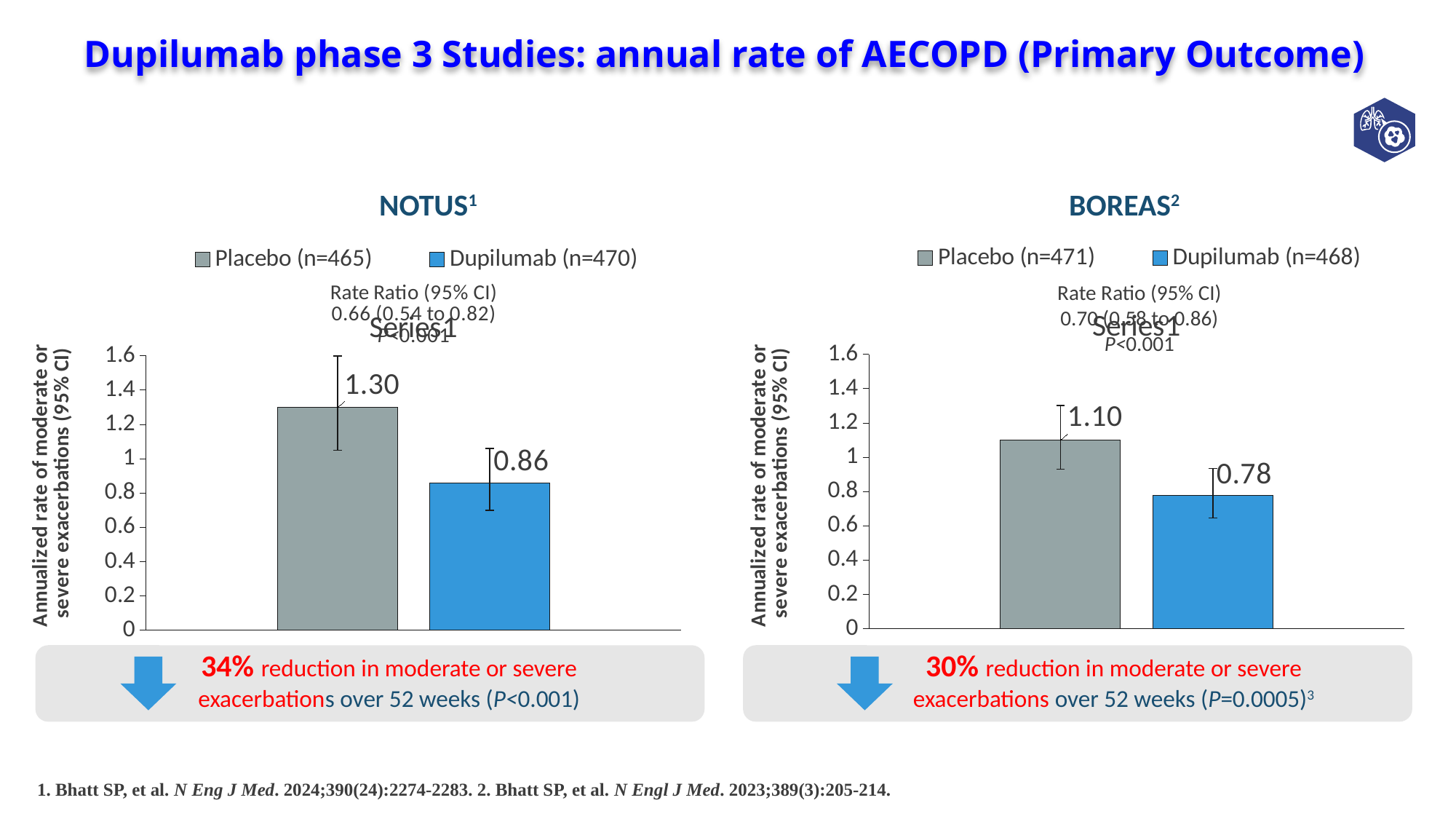
How many series does the legend of the NOTUS chart list? 2 In the BOREAS chart, what is the annualized rate of moderate or severe exacerbations for Placebo (n=471)? 1.10 In the NOTUS chart, what is the difference between the Placebo and Dupilumab annualized exacerbation rates? 0.44 In the NOTUS chart, what is the annualized rate of moderate or severe exacerbations for Dupilumab (n=470)? 0.86 In the BOREAS chart, what is the annualized rate of moderate or severe exacerbations for Dupilumab (n=468)? 0.78 In the BOREAS chart, which group has the lower annualized exacerbation rate? Dupilumab (n=468) In the NOTUS chart, which group has the higher annualized exacerbation rate? Placebo (n=465) In the NOTUS chart, what is the rate ratio (95% CI) shown above the bars? 0.66 (0.54 to 0.82) What kind of chart is used for the BOREAS study? Bar chart In the NOTUS chart, what is the annualized rate of moderate or severe exacerbations for Placebo (n=465)? 1.30 In the BOREAS chart, what is the difference between the Placebo and Dupilumab annualized exacerbation rates? 0.32 In the BOREAS chart, is the Placebo rate greater or less than 1? greater